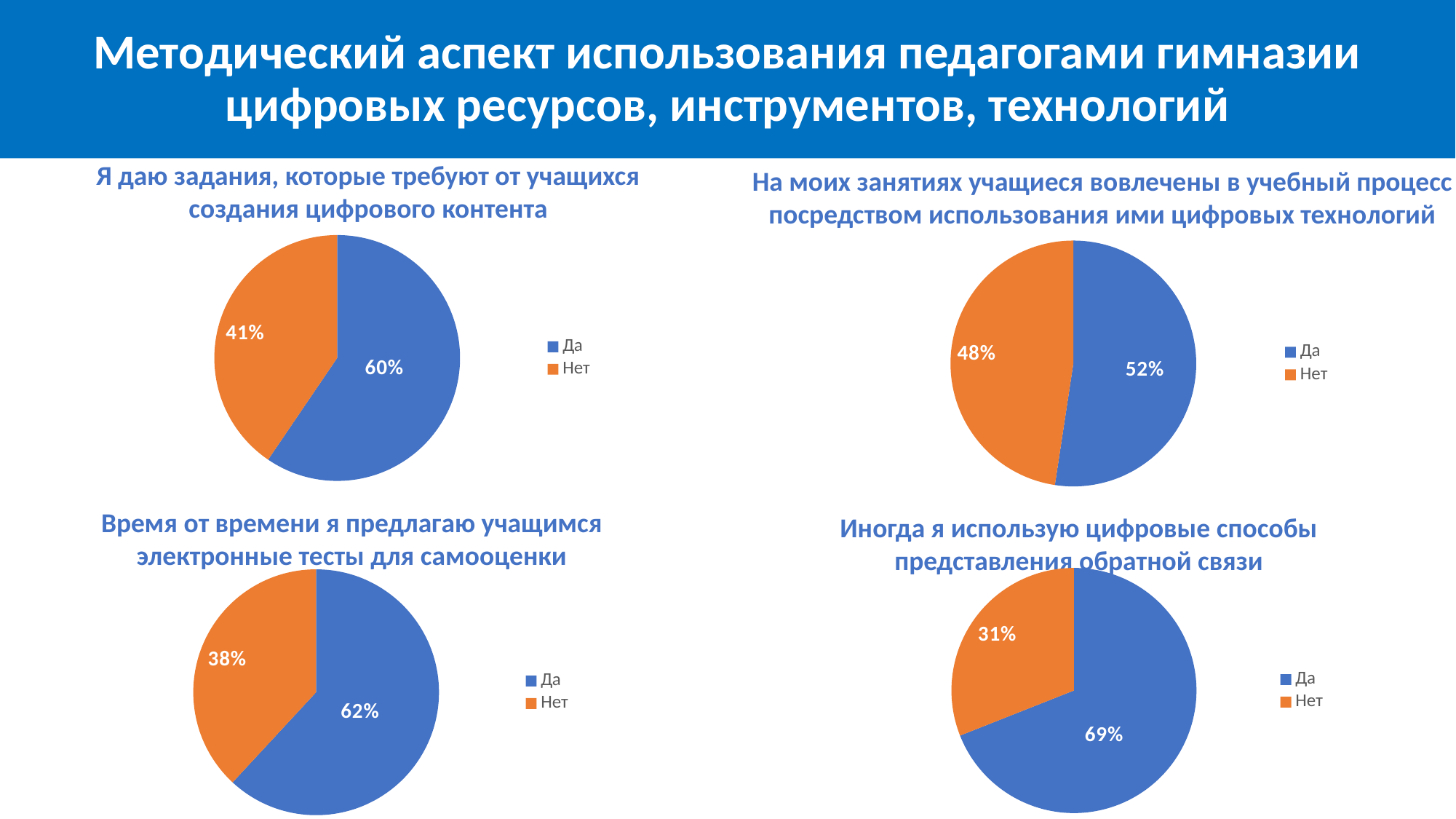
In the top-right pie chart ("На моих занятиях учащиеся вовлечены в учебный процесс..."), which slice is the largest? Да In the top-left pie chart ("Я даю задания, которые требуют от учащихся создания цифрового контента"), what share is labelled for "Да"? 60% In the top-right pie chart ("На моих занятиях учащиеся вовлечены в учебный процесс..."), what value is shown for "Нет"? 48% What type of chart is used for "Иногда я использую цифровые способы представления обратной связи" (bottom-right)? Pie chart In the top-right pie chart ("На моих занятиях учащиеся вовлечены в учебный процесс..."), what share is labelled for "Да"? 52% In the bottom-right pie chart ("Иногда я использую цифровые способы представления обратной связи"), what is the difference between the "Да" and "Нет" values? 38% In the top-left pie chart ("Я даю задания, которые требуют от учащихся создания цифрового контента"), what value is shown for "Нет"? 41% How many slices does the top-left pie chart ("Я даю задания, которые требуют от учащихся создания цифрового контента") have? 2 In the bottom-right pie chart ("Иногда я использую цифровые способы представления обратной связи"), what value is shown for "Да"? 69% In the bottom-left pie chart ("Время от времени я предлагаю учащимся электронные тесты для самооценки"), which slice is larger, "Да" or "Нет"? Да In the bottom-left pie chart ("Время от времени я предлагаю учащимся электронные тесты для самооценки"), what share is labelled for "Нет"? 38% In the bottom-left pie chart ("Время от времени я предлагаю учащимся электронные тесты для самооценки"), what colour is the "Нет" slice? Orange